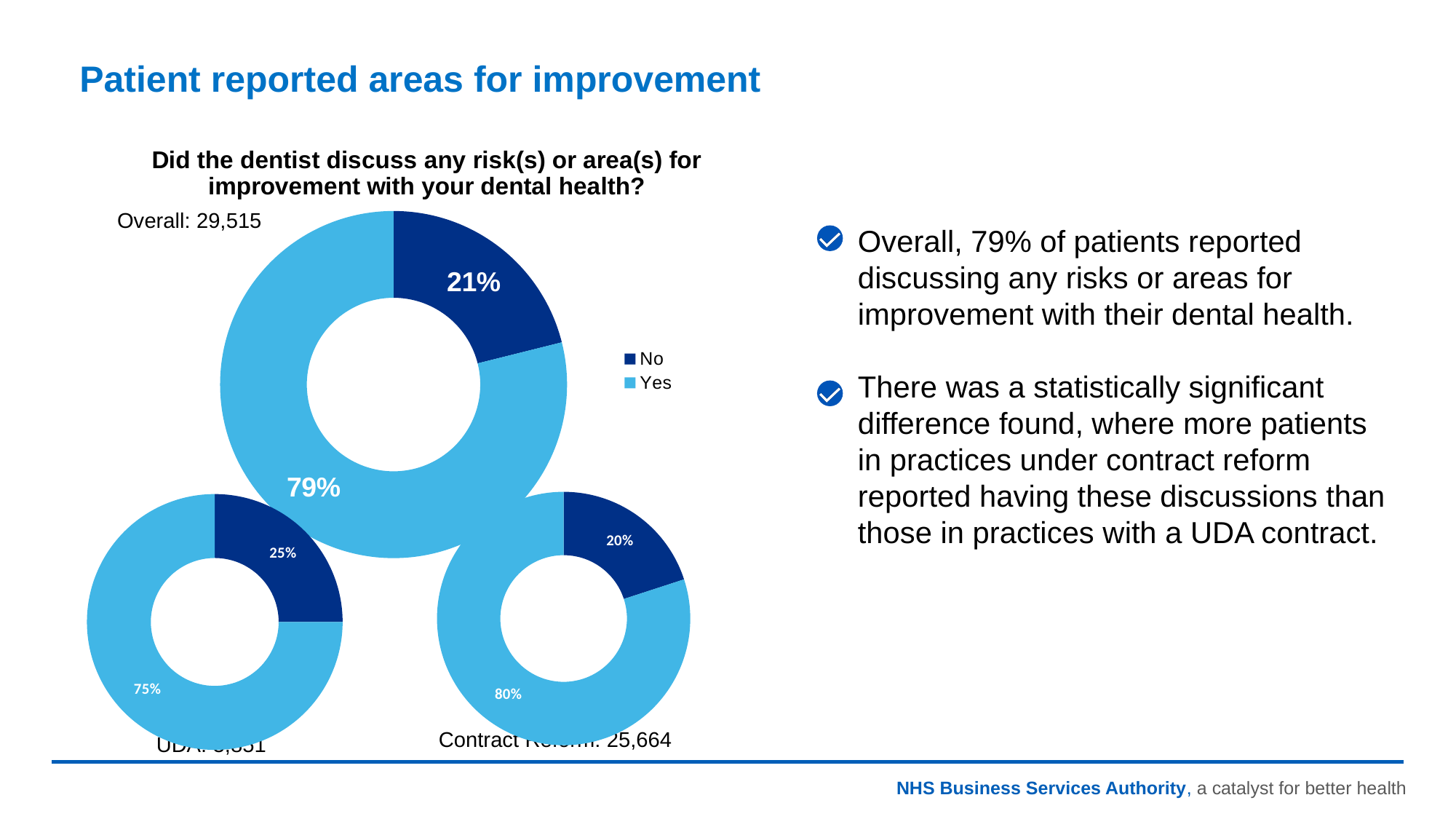
In the Contract Reform chart, what percentage answered No? 20% In the Overall chart, what percentage of patients answered Yes? 79% In the Overall chart, what percentage of patients answered No? 21% In the Contract Reform chart, what percentage answered Yes? 80% What is the difference between the Yes share in the Contract Reform chart and the Yes share in the UDA chart? 5 percentage points What is the sample size shown for the Contract Reform chart? 25,664 In the bottom-left UDA chart, what percentage answered Yes? 75% How many entries does the legend list for the Overall chart? 2 What is the sample size shown for the Overall chart? 29,515 In the Overall chart, which response has the larger share, Yes or No? Yes What kind of chart is the large Overall chart on the slide? Doughnut chart In the bottom-left UDA chart, what percentage answered No? 25%